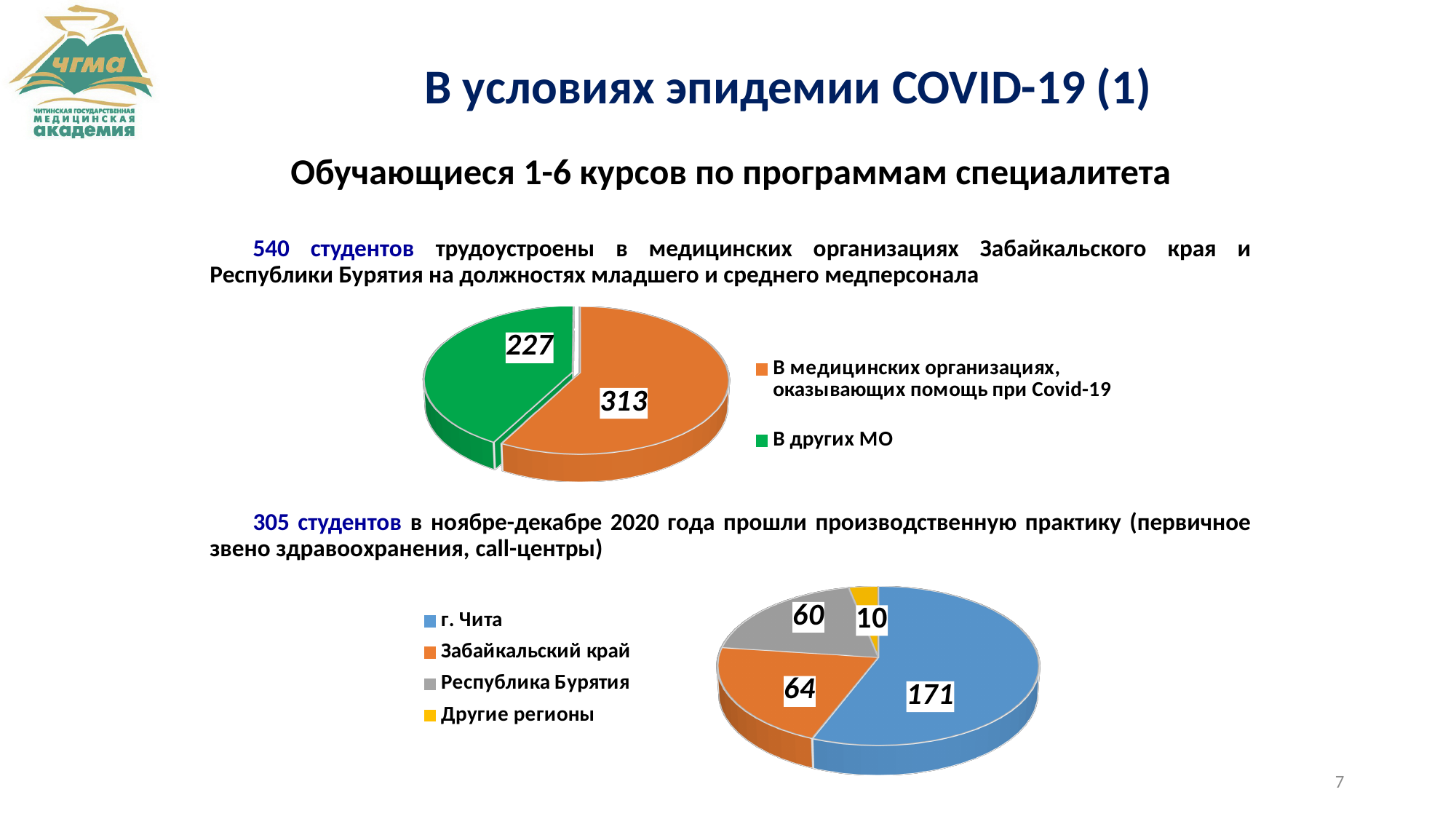
In the upper pie chart, what is the value for В других МО? 227 In the upper pie chart, how many students are in medical organizations providing Covid-19 care (В медицинских организациях, оказывающих помощь при Covid-19)? 313 What type of chart is the upper chart? Pie chart In the lower pie chart, which category has the smallest value? Другие регионы In the lower pie chart, what is the difference between г. Чита and Забайкальский край? 107 In the lower pie chart, what is the value for г. Чита? 171 How many categories does the legend of the lower pie chart list? 4 In the lower pie chart, which is larger: Забайкальский край or Республика Бурятия? Забайкальский край In the lower pie chart, which category has the largest value? г. Чита In the upper pie chart, what is the difference between the two slices? 86 In the upper pie chart, what is the total of the two slices? 540 In the lower pie chart, what is the value for Республика Бурятия? 60